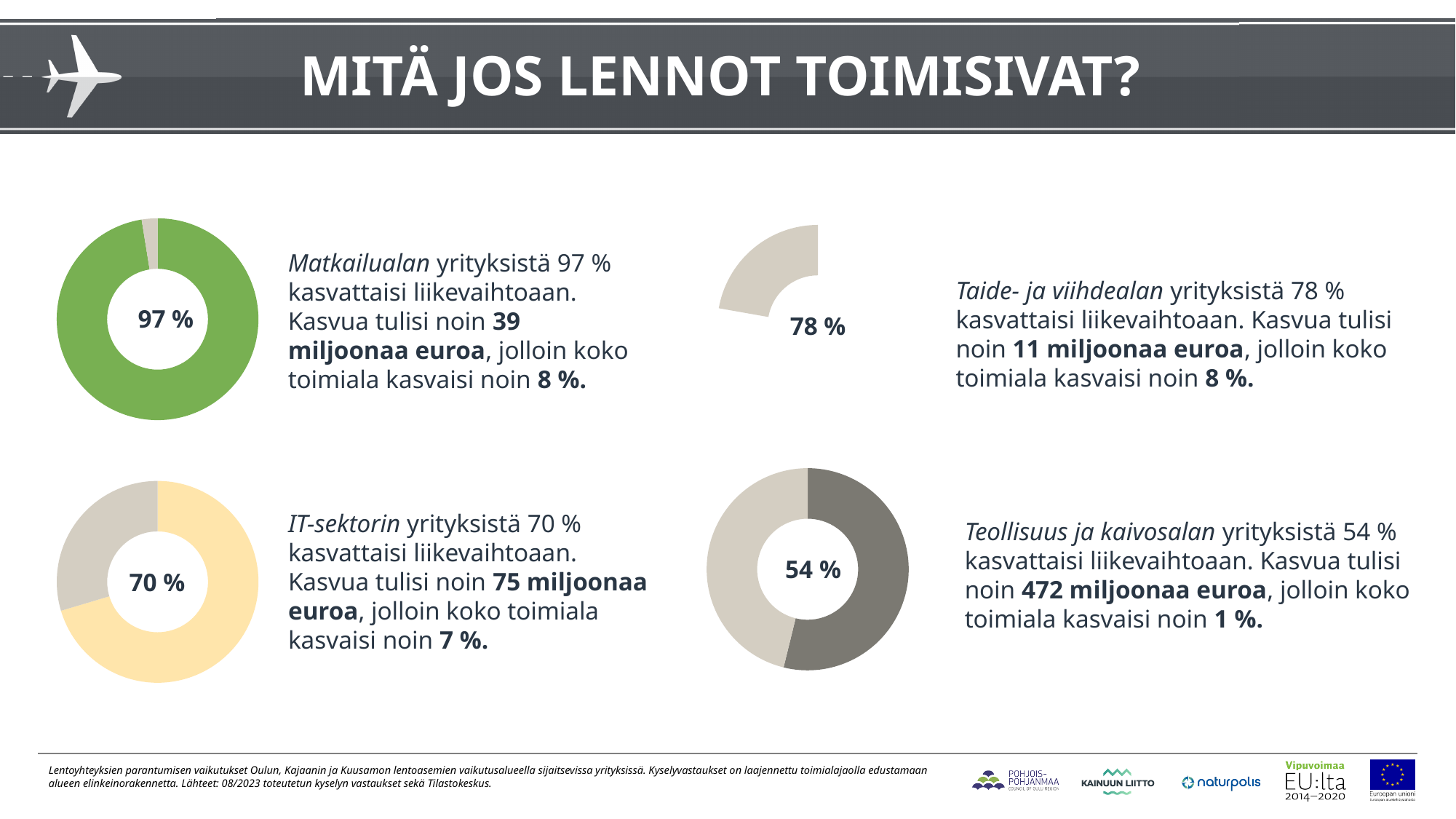
Across the four charts on the slide, which sector has the highest share of companies that would grow their turnover? Matkailuala What kind of chart is the top-left chart on the slide? Donut (pie) chart What is the difference between the value in the top-right chart (78 %) and the value in the bottom-left chart (70 %)? 8 % What colour is the filled portion of the top-left donut chart? Green How many charts are shown on the slide? 4 What value is shown in the centre of the bottom-right donut chart (Teollisuus ja kaivosala)? 54 % What value is shown in the centre of the bottom-left donut chart (IT-sektori)? 70 % Which is larger: the value in the bottom-left chart (IT-sektori) or the value in the top-right chart (Taide- ja viihdeala)? Taide- ja viihdeala Across the four charts on the slide, which sector has the lowest share of companies that would grow their turnover? Teollisuus ja kaivosala What is the difference between the value in the top-left chart (97 %) and the value in the bottom-right chart (54 %)? 43 % What value is shown in the centre of the top-left donut chart (Matkailuala)? 97 % What value is shown next to the top-right chart (Taide- ja viihdeala)? 78 %